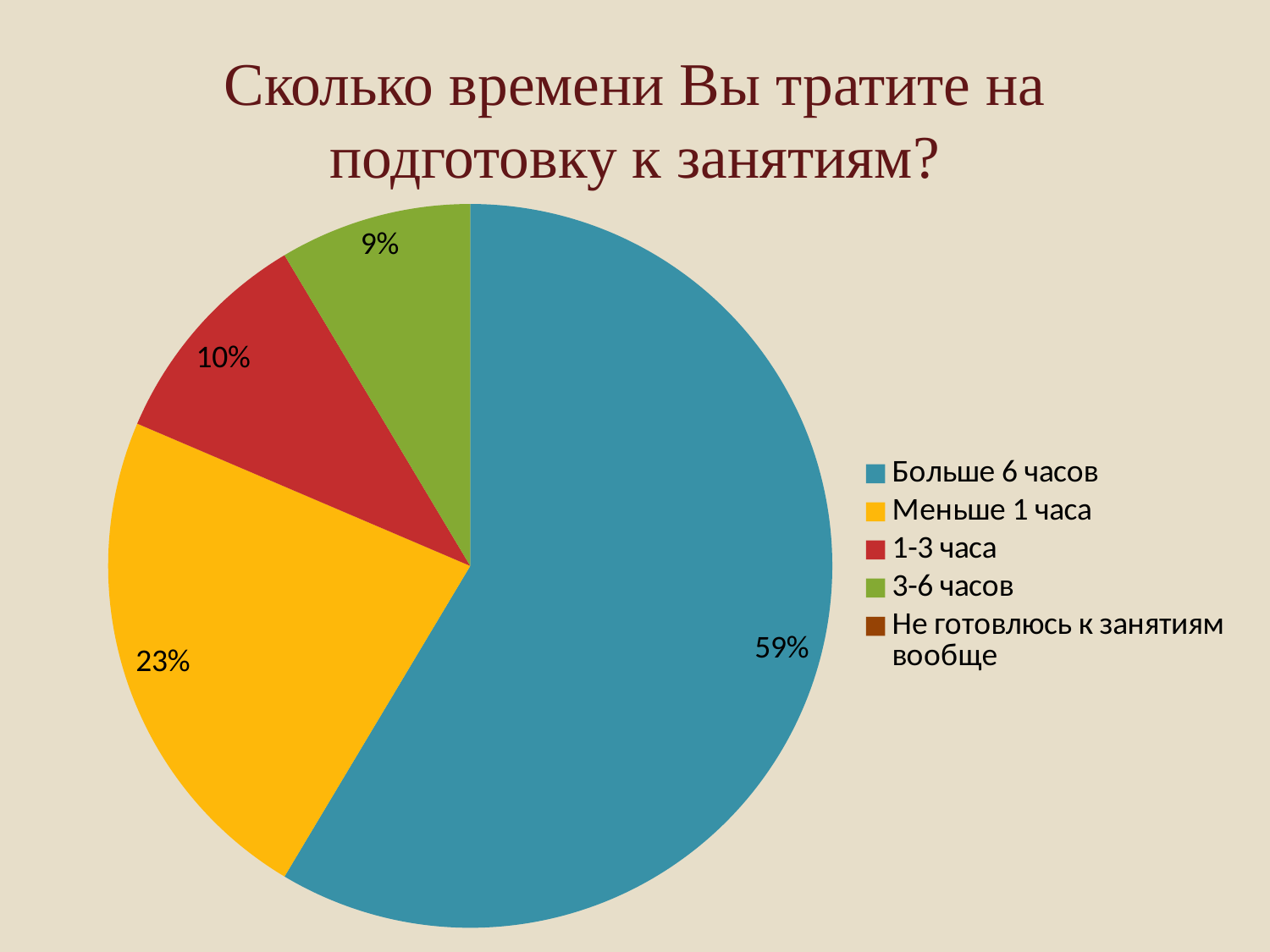
What kind of chart is shown on the slide? pie chart Which is larger, the share for "1-3 часа" or the share for "3-6 часов"? 1-3 часа What colour is the slice for "Меньше 1 часа"? yellow How many categories does the legend list? 5 What is the value shown for "3-6 часов"? 9% Which of the labelled slices is the smallest? 3-6 часов What is the value shown for "1-3 часа"? 10% What is the value shown for "Меньше 1 часа"? 23% Which category has the largest slice of the pie? Больше 6 часов What share of the pie does "Больше 6 часов" take? 59% What is the title of the chart? Сколько времени Вы тратите на подготовку к занятиям? What is the difference between the shares for "Больше 6 часов" and "Меньше 1 часа"? 36%